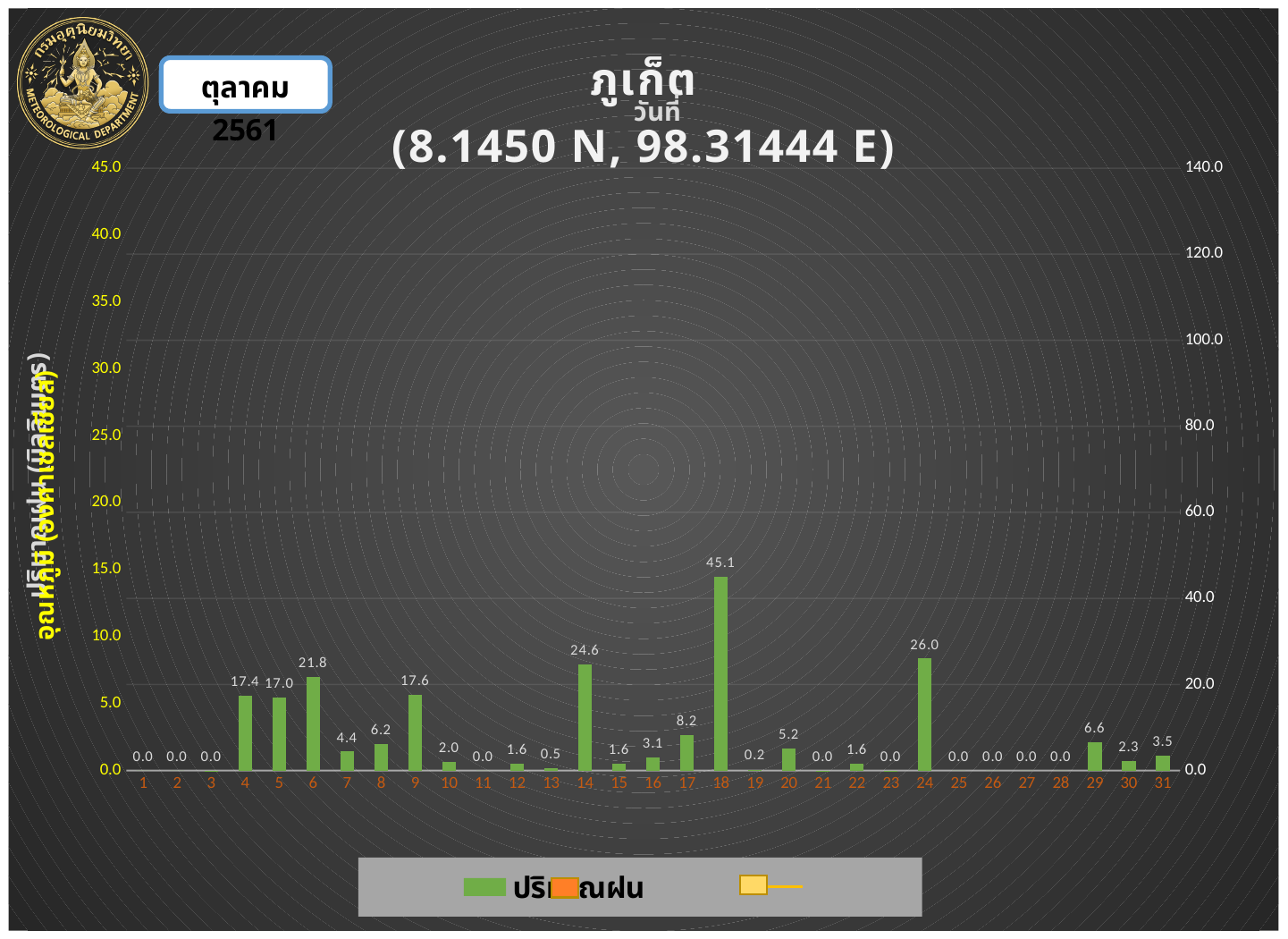
What coordinates are given in the chart title? 8.1450 N, 98.31444 E Which is larger, the value for day 14 or the value for day 24? day 24 What is the difference between the values for day 4 and day 5? 0.4 What kind of chart is shown on the slide? bar chart What is the rainfall value shown for day 18? 45.1 What is the value labelled on the bar for day 24? 26.0 What is the value shown for day 6? 21.8 What is the value shown for day 14? 24.6 What is the difference between the values for day 18 and day 24? 19.1 Which is larger, the value for day 6 or the value for day 9? day 6 How many days are shown along the x axis of the chart? 31 Which day has the highest bar in the chart? 18